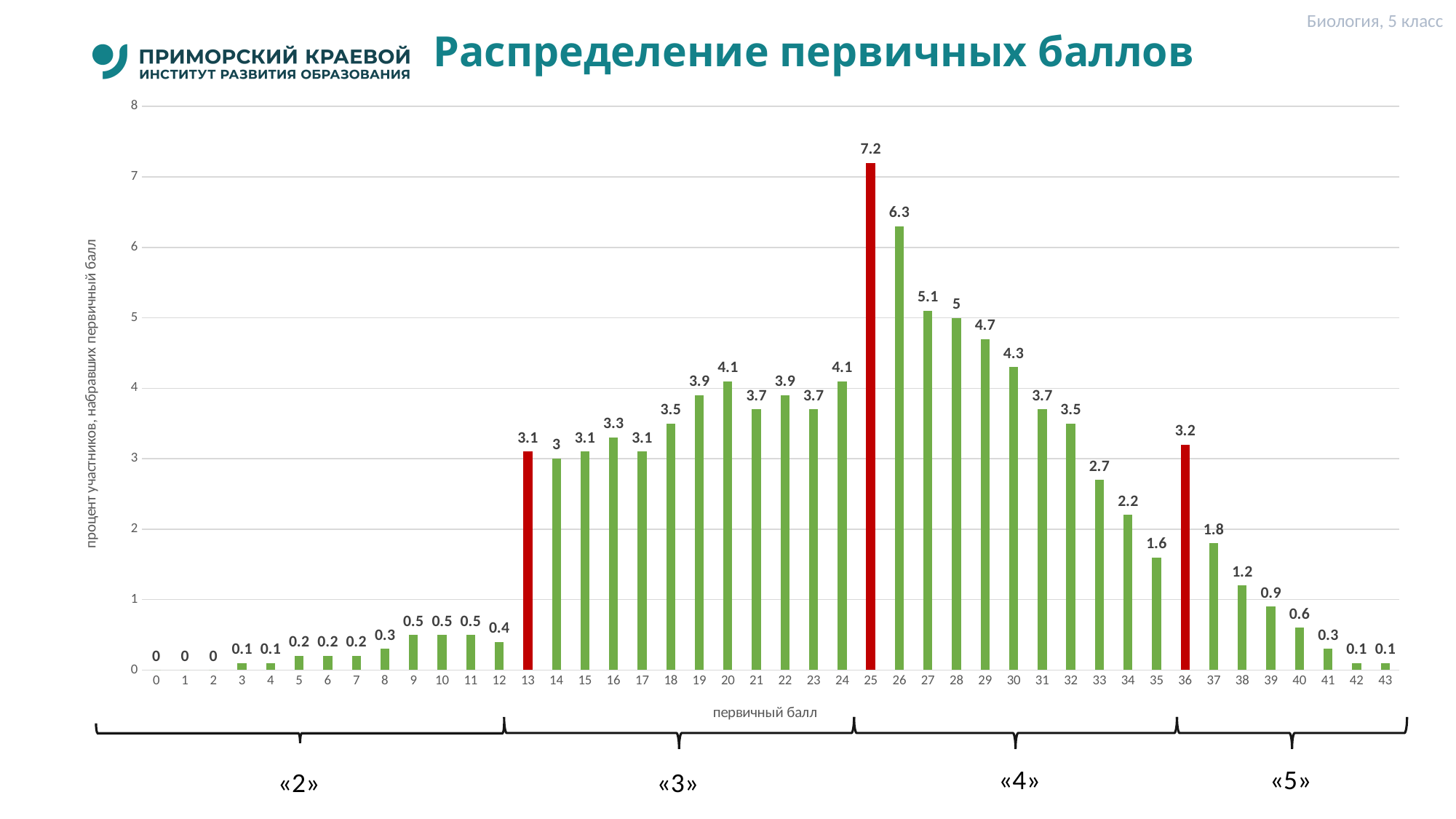
What is the value for primary score 36? 3.2 What kind of chart is shown on the slide? bar chart How many primary score categories are shown on the x axis? 44 Which primary scores are shown with red bars? 13, 25 and 36 Is the value for primary score 27 greater or less than 5? greater Which primary score has the highest percentage of participants? 25 Which is larger, the value for primary score 20 or for primary score 30? 30 What is the title of the chart? Распределение первичных баллов What is the difference between the values for primary scores 25 and 26? 0.9 What is the value for primary score 13? 3.1 What is the value for primary score 25? 7.2 Do the values rise or fall from primary score 26 to primary score 35? fall